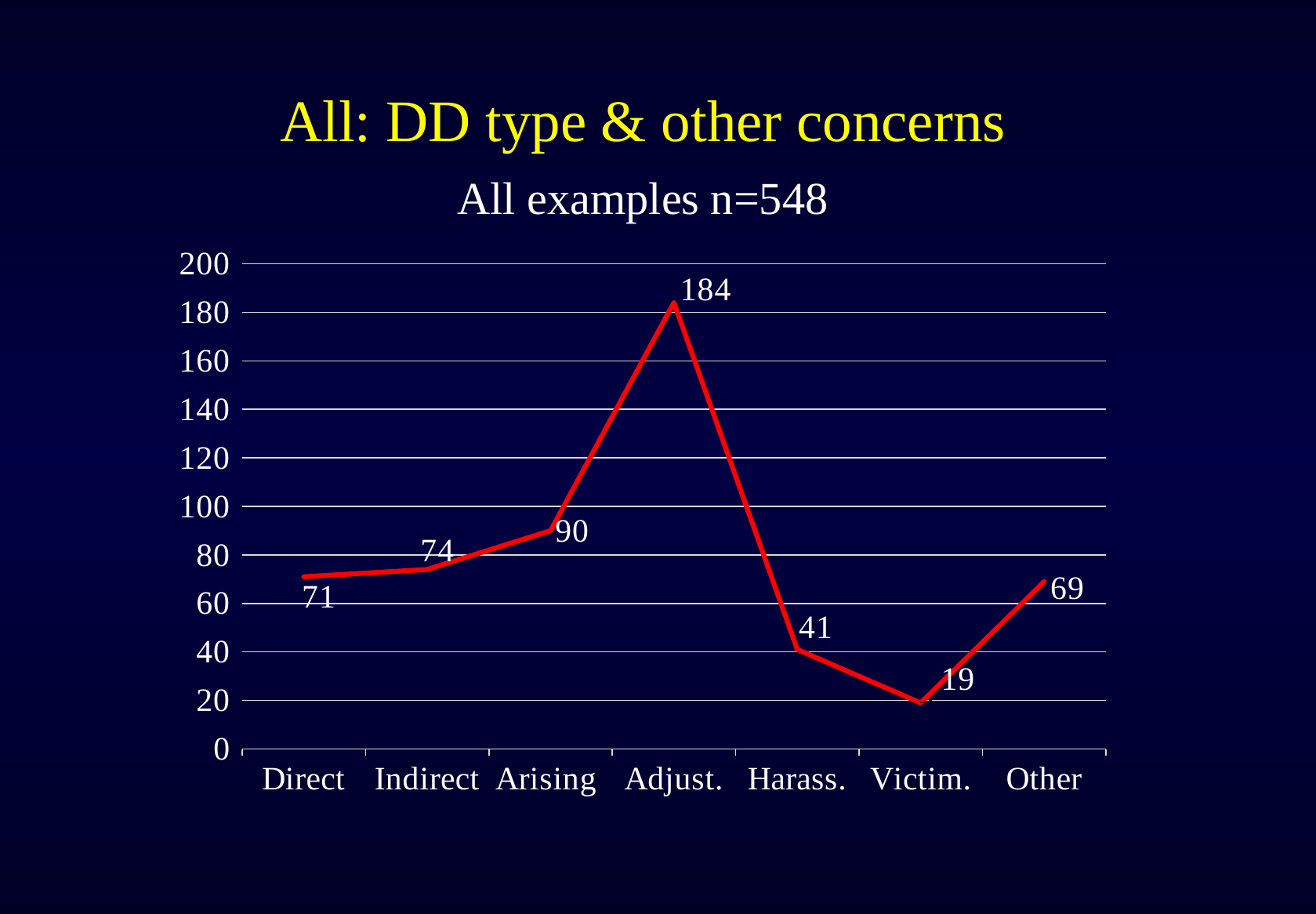
Which is larger, the value for Direct or the value for Other? Direct What kind of chart is this? Line chart Which category has the lowest value? Victim. How many categories are shown on the x axis? 7 What is the value for Other? 69 What is the difference between the values for Harass. and Victim.? 22 What is the value for Victim.? 19 What is the value for Indirect? 74 What is the difference between the values for Adjust. and Arising? 94 What is the chart's subtitle below the main title? All examples n=548 Which category has the highest value? Adjust. What is the value for Adjust.? 184